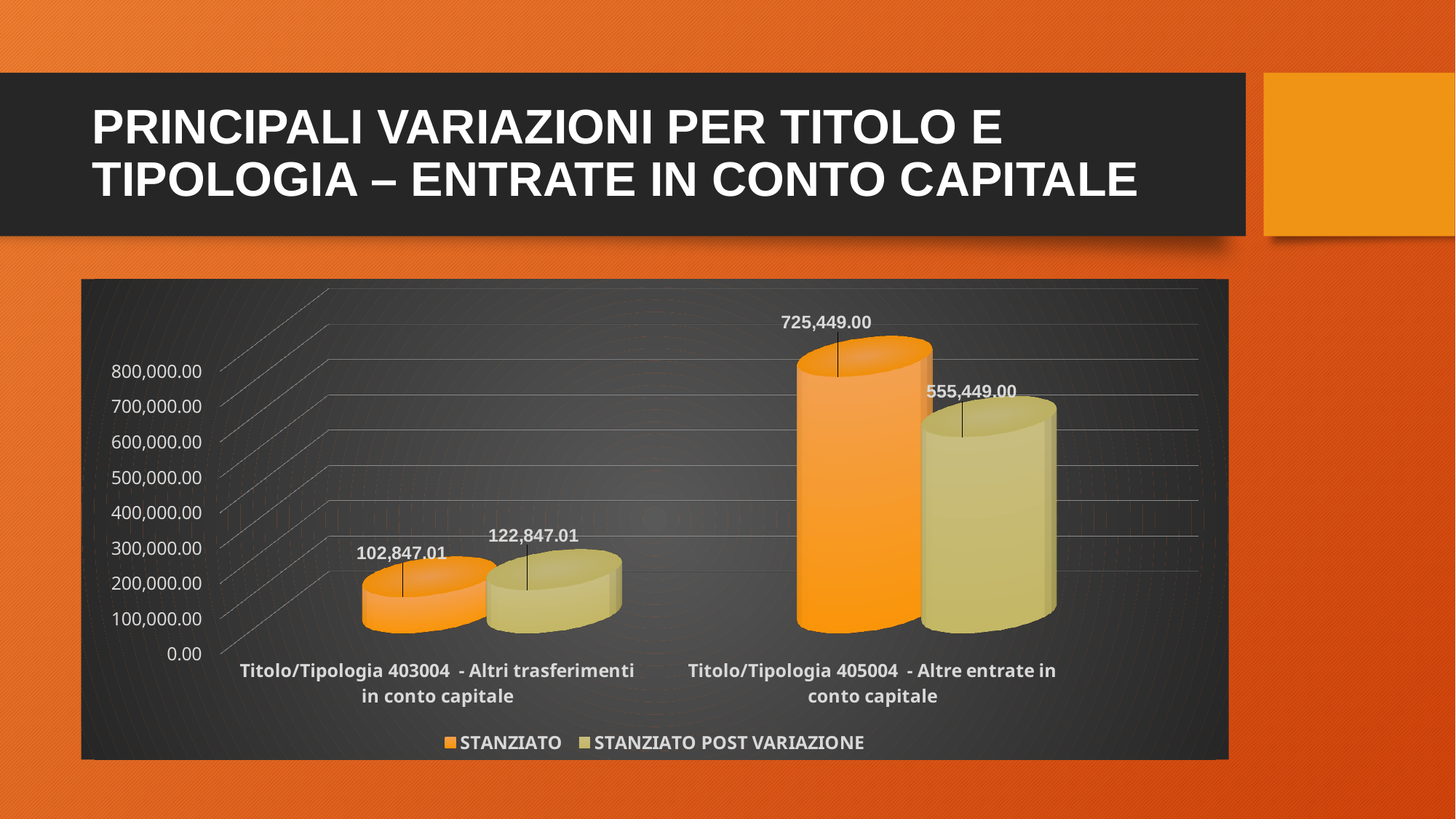
For Titolo/Tipologia 405004 - Altre entrate in conto capitale, which is larger: STANZIATO or STANZIATO POST VARIAZIONE? STANZIATO What is the STANZIATO value for Titolo/Tipologia 405004 - Altre entrate in conto capitale? 725,449.00 What kind of chart is shown on the slide? Bar chart Which category has the highest STANZIATO value? Titolo/Tipologia 405004 - Altre entrate in conto capitale How many categories are shown on the x axis of the chart? 2 What is the STANZIATO POST VARIAZIONE value for Titolo/Tipologia 403004 - Altri trasferimenti in conto capitale? 122,847.01 What is the difference between the STANZIATO POST VARIAZIONE and STANZIATO values for Titolo/Tipologia 403004 - Altri trasferimenti in conto capitale? 20,000.00 What is the STANZIATO POST VARIAZIONE value for Titolo/Tipologia 405004 - Altre entrate in conto capitale? 555,449.00 What is the difference between the STANZIATO and STANZIATO POST VARIAZIONE values for Titolo/Tipologia 405004 - Altre entrate in conto capitale? 170,000.00 Which category has the lowest STANZIATO POST VARIAZIONE value? Titolo/Tipologia 403004 - Altri trasferimenti in conto capitale How many series does the chart legend list? 2 What is the STANZIATO value for Titolo/Tipologia 403004 - Altri trasferimenti in conto capitale? 102,847.01